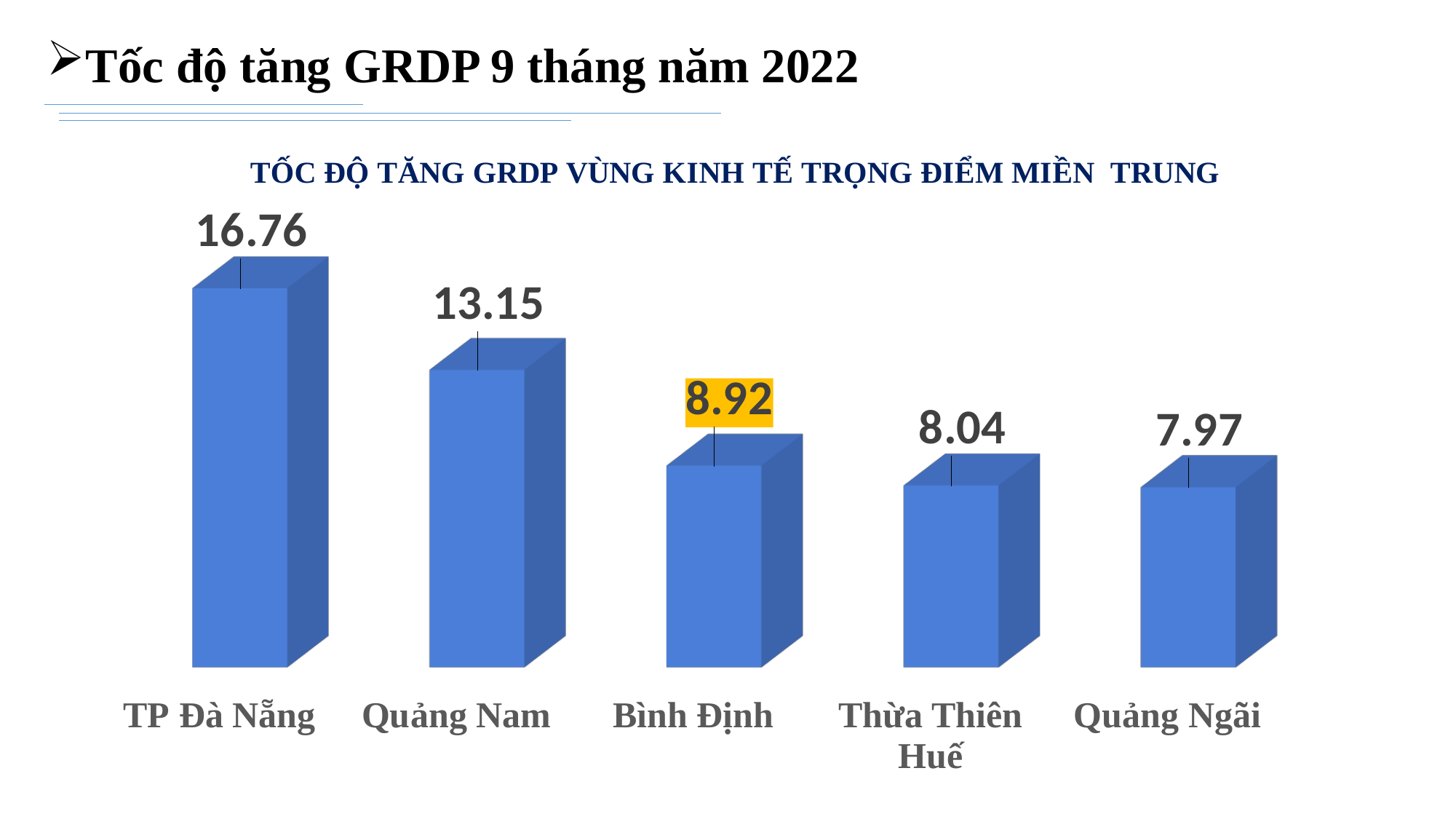
What is the value for Bình Định? 8.92 What is the value for Thừa Thiên Huế? 8.04 How many categories are shown in the chart? 5 Which category has the highest value? TP Đà Nẵng Which is larger, the value for Quảng Nam or the value for Bình Định? Quảng Nam What is the value for TP Đà Nẵng? 16.76 What is the difference between the values for TP Đà Nẵng and Quảng Nam? 3.61 Which category has the lowest value? Quảng Ngãi What is the title of the chart? TỐC ĐỘ TĂNG GRDP VÙNG KINH TẾ TRỌNG ĐIỂM MIỀN TRUNG What kind of chart is shown on the slide? Bar chart What is the value for Quảng Nam? 13.15 What is the value for Quảng Ngãi? 7.97